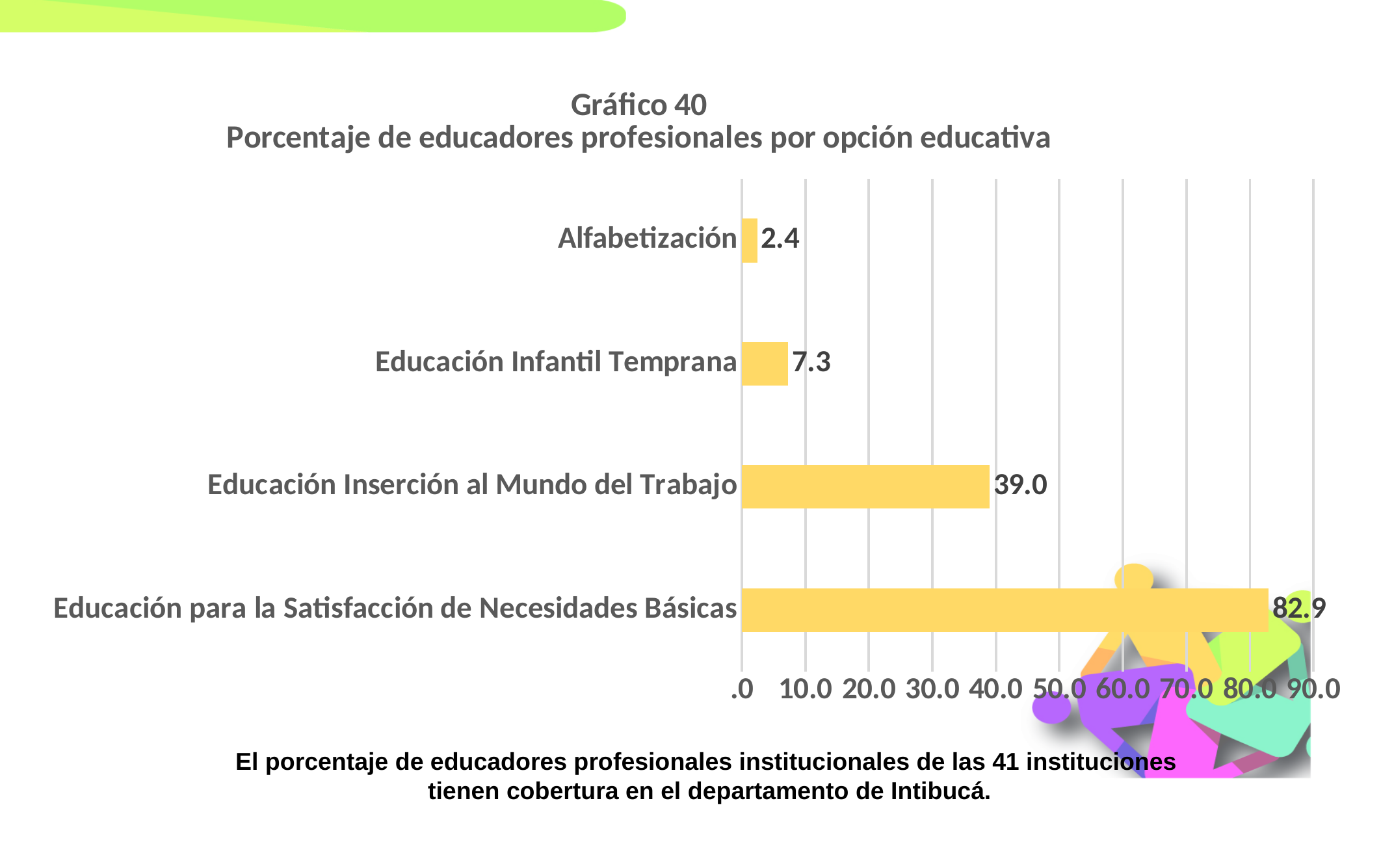
What is the value for Educación Inserción al Mundo del Trabajo? 39.0 What is the value for Educación para la Satisfacción de Necesidades Básicas? 82.9 Is the value for Educación Inserción al Mundo del Trabajo greater or less than 40.0? less What is the difference between the values for Educación Infantil Temprana and Alfabetización? 4.9 What is the difference between the values for Educación para la Satisfacción de Necesidades Básicas and Educación Inserción al Mundo del Trabajo? 43.9 How many categories are shown in the chart? 4 Which is larger, the value for Educación Infantil Temprana or the value for Alfabetización? Educación Infantil Temprana Which category has the lowest value? Alfabetización What is the value for Alfabetización? 2.4 What kind of chart is shown on the slide? bar chart What is the value for Educación Infantil Temprana? 7.3 Which category has the highest value? Educación para la Satisfacción de Necesidades Básicas